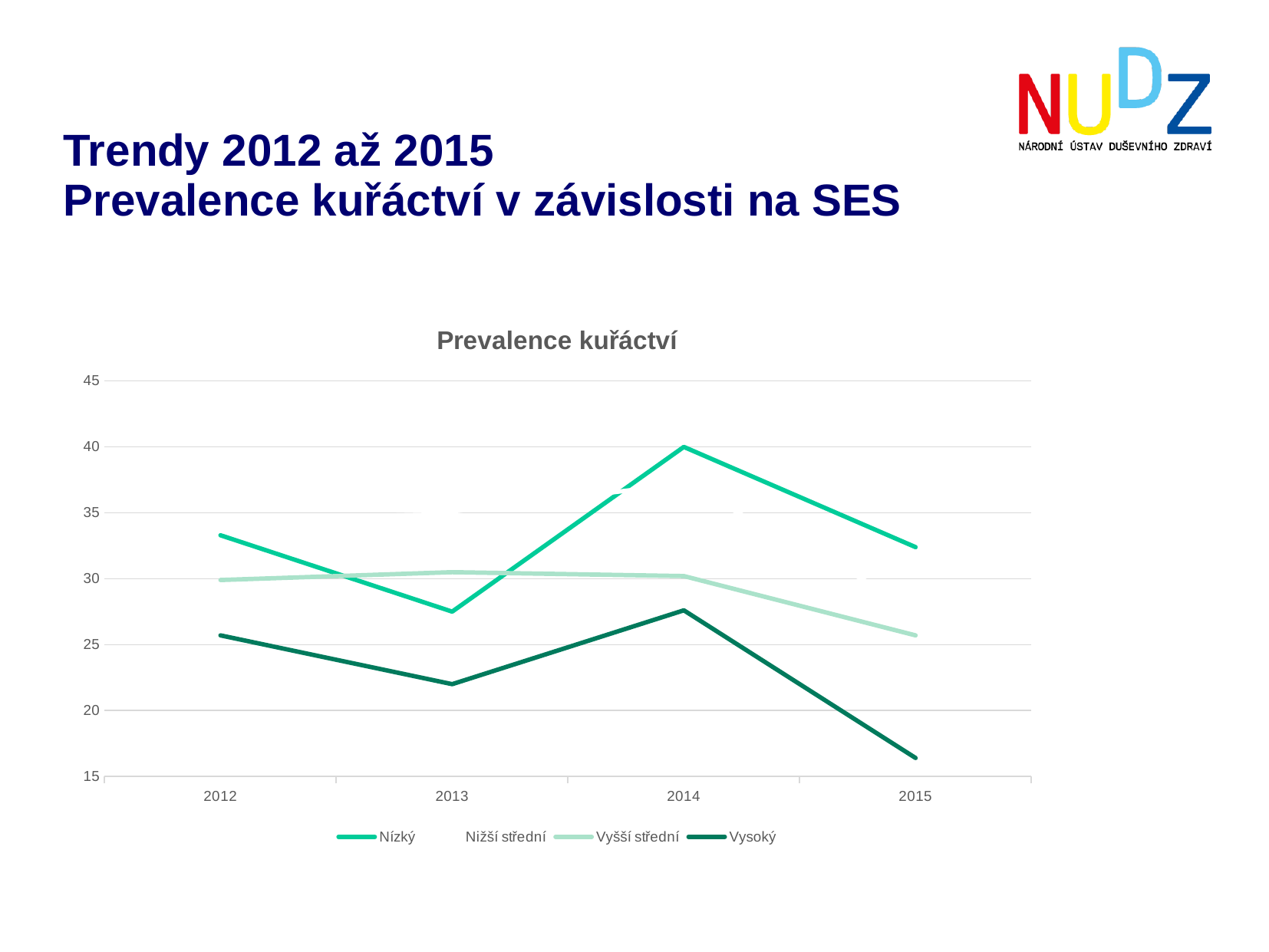
Is the value for Vyšší střední in 2015 greater or less than 30? less Which series has the lowest value in 2015? Vysoký Is the value for Vysoký in 2015 greater or less than 20? less What is the title of the chart? Prevalence kuřáctví Is the value for Nízký in 2013 greater or less than 30? less Does the Vysoký series rise or fall from 2014 to 2015? fall How many series does the legend of the chart list? 4 What kind of chart is shown on the slide? line chart In 2012, which is larger: the value for Nízký or the value for Vysoký? Nízký How many years are shown on the x axis of the chart? 4 In which year does the Nízký series reach its highest value? 2014